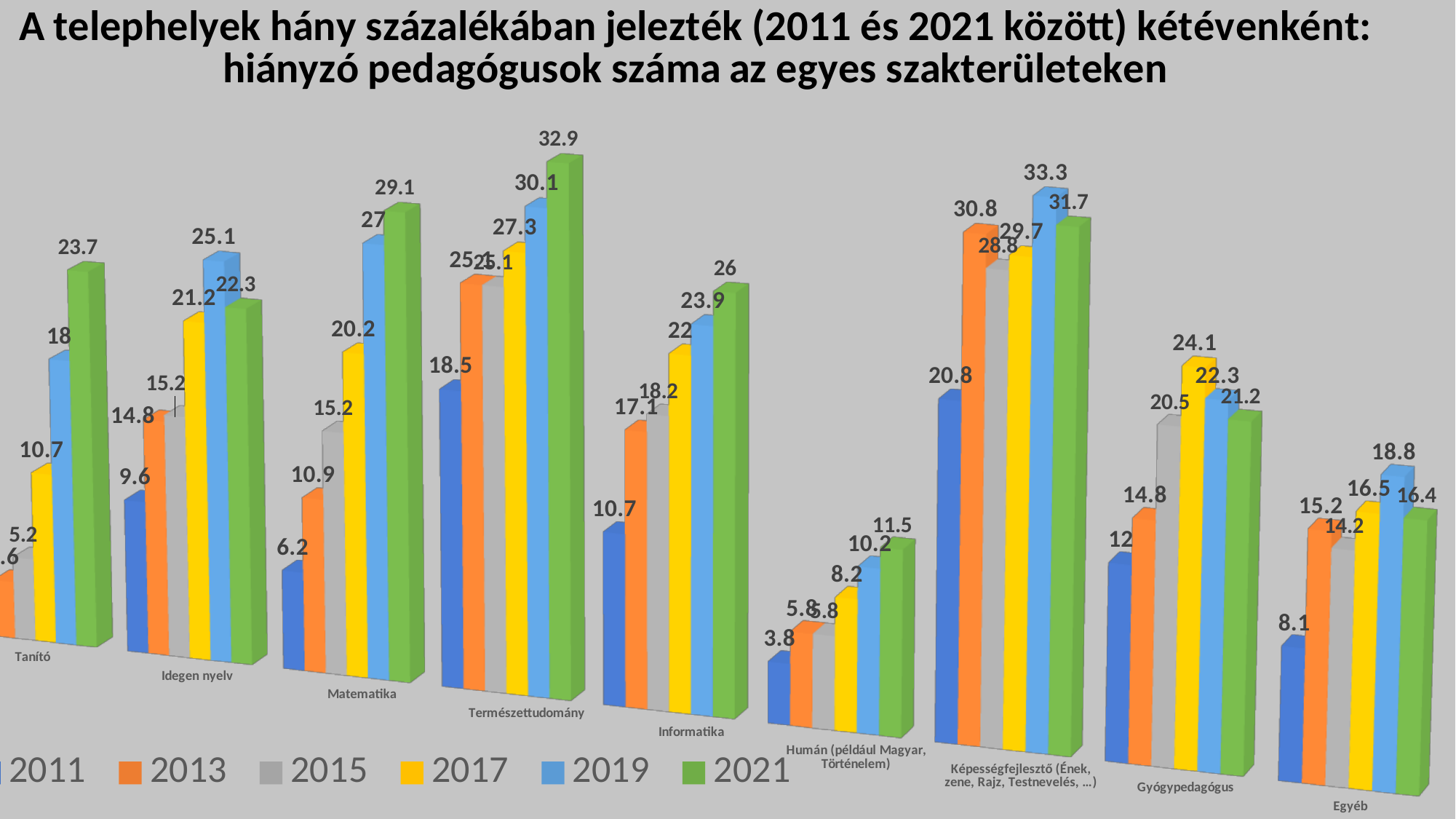
What is the value for Gyógypedagógus in 2017? 24.1 What is the value for Matematika in 2021? 29.1 What kind of chart is shown on the slide? Bar chart Do the values for Informatika rise or fall from 2011 to 2021? Rise What is the difference between the 2021 and 2011 values for Matematika? 22.9 What is the value for Egyéb in 2019? 18.8 How many series does the legend list? 6 Which category has the highest value in 2019? Képességfejlesztő (Ének, zene, Rajz, Testnevelés, ...) What is the value for Informatika in 2011? 10.7 Which is larger: the 2019 value for Idegen nyelv or the 2019 value for Informatika? Idegen nyelv Which category has the lowest value in 2021? Humán (például Magyar, Történelem) How many categories are shown on the x axis? 9